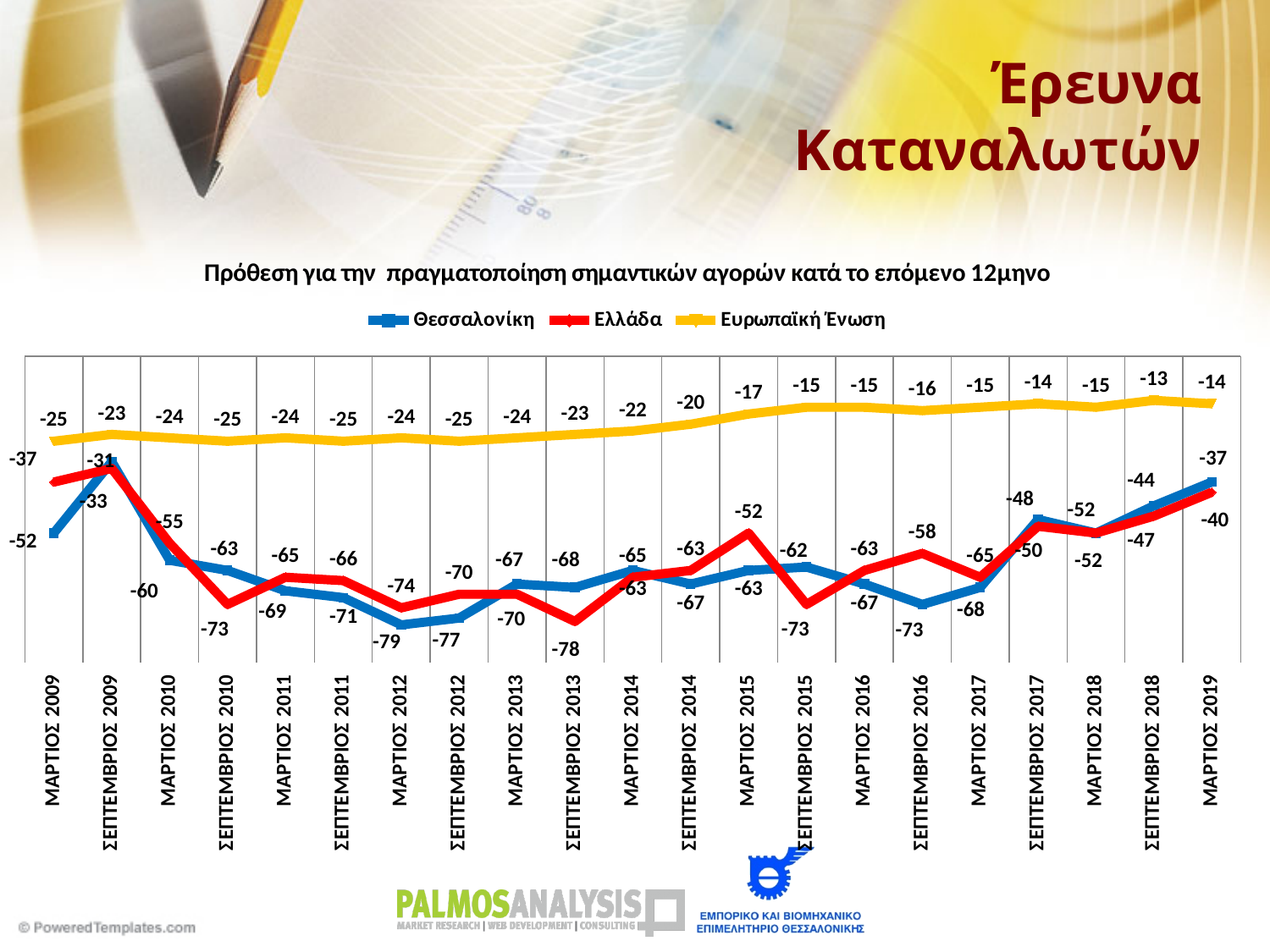
In which period does Θεσσαλονίκη reach its lowest value? ΜΑΡΤΙΟΣ 2012 What is the value for Ευρωπαϊκή Ένωση in ΜΑΡΤΙΟΣ 2019? -14 What is the difference between the Ευρωπαϊκή Ένωση value and the Θεσσαλονίκη value in ΜΑΡΤΙΟΣ 2019? 23 What colour is the line for Ελλάδα? Red In ΜΑΡΤΙΟΣ 2015, which is higher: Ελλάδα or Θεσσαλονίκη? Ελλάδα What is the value for Θεσσαλονίκη in ΜΑΡΤΙΟΣ 2009? -52 In which period does Ευρωπαϊκή Ένωση reach its highest value? ΣΕΠΤΕΜΒΡΙΟΣ 2018 What type of chart is shown on the slide? Line chart What is the value for Ελλάδα in ΣΕΠΤΕΜΒΡΙΟΣ 2013? -78 Does the Ευρωπαϊκή Ένωση series generally rise or fall from ΜΑΡΤΙΟΣ 2009 to ΜΑΡΤΙΟΣ 2019? Rise How many series does the legend list? 3 How many time points are plotted along the x axis? 21